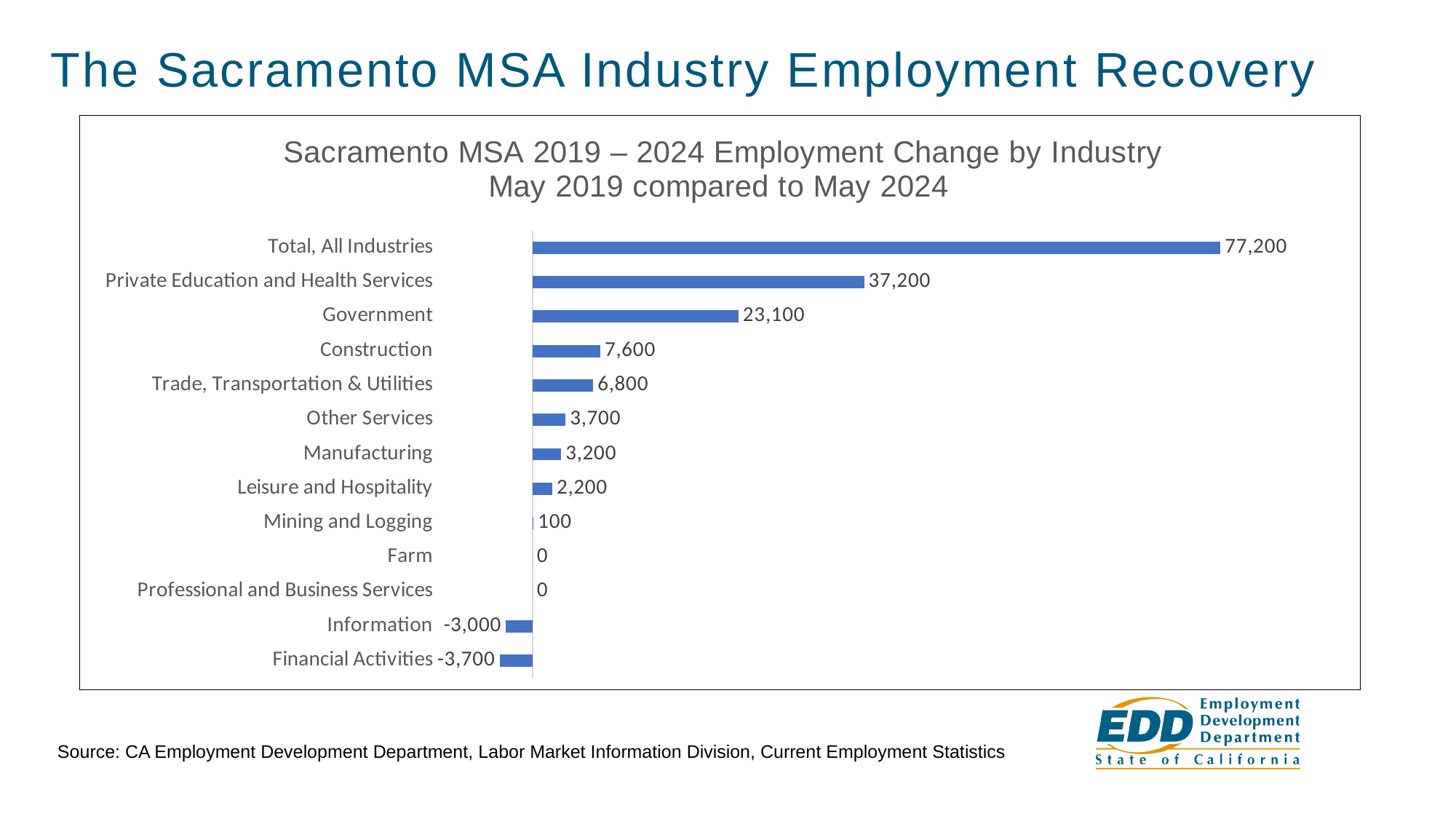
What kind of chart is shown on the slide? Bar chart What is the title of the chart? Sacramento MSA 2019 – 2024 Employment Change by Industry May 2019 compared to May 2024 How many categories are shown in the chart? 13 What is the employment change for Construction? 7,600 Which has a larger employment change, Other Services or Manufacturing? Other Services Which two categories show an employment change of 0? Farm and Professional and Business Services What is the employment change for Mining and Logging? 100 What is the difference between the employment change for Private Education and Health Services and Government? 14,100 What is the employment change for Financial Activities? -3,700 Which category has the lowest employment change? Financial Activities Which industry (excluding the total) has the highest employment change? Private Education and Health Services What is the employment change for Government? 23,100